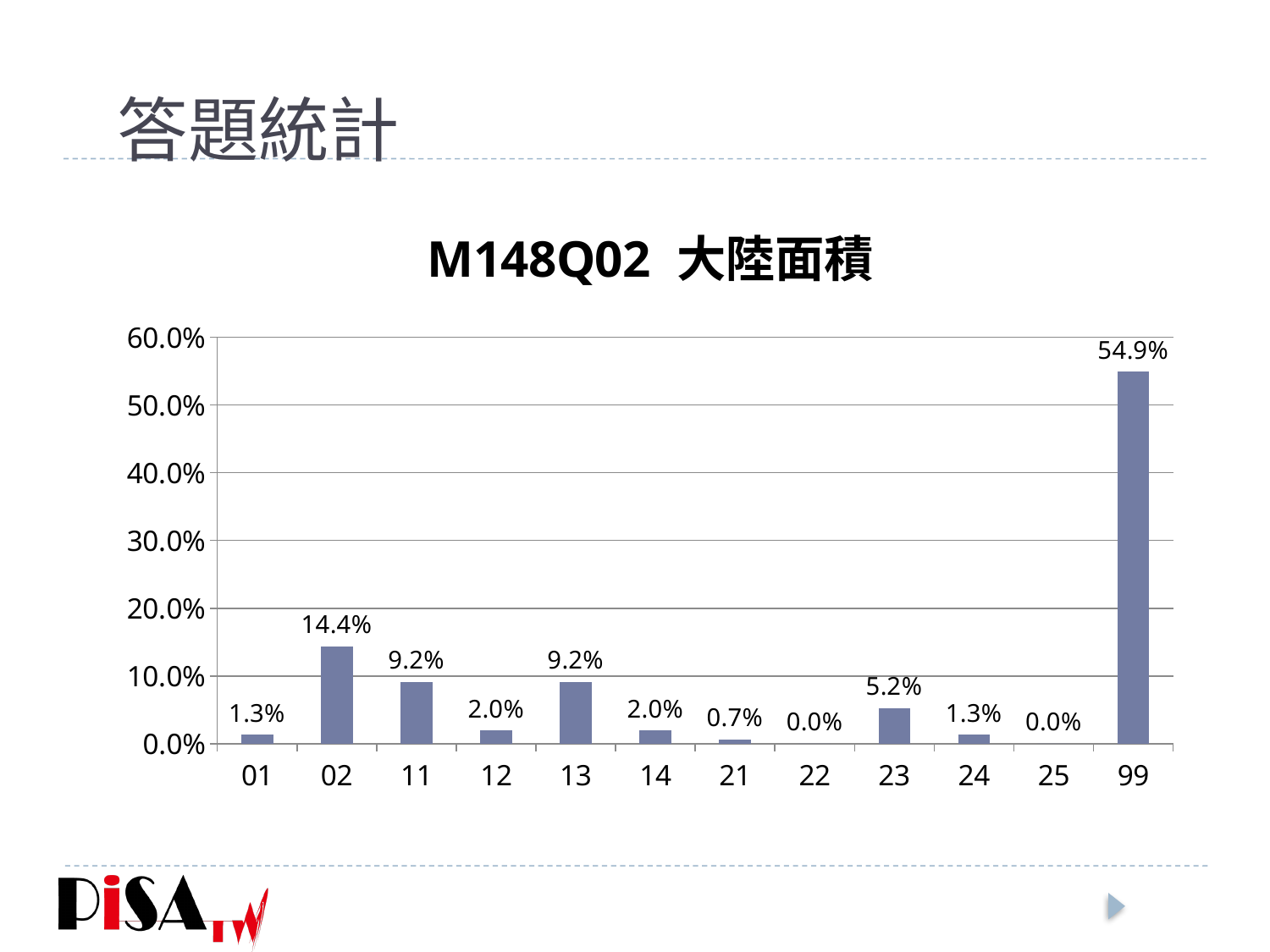
What kind of chart is this? bar chart Is the value for 99 greater or less than 50.0%? greater What is the title of the chart? M148Q02 大陸面積 Which is larger, the value for 23 or the value for 24? 23 What is the value for category 02? 14.4% What is the difference between the values for 99 and 02? 40.5% What is the difference between the values for 02 and 11? 5.2% Which category has the highest value? 99 What is the value for category 23? 5.2% How many categories are shown on the x axis? 12 What is the value for category 99? 54.9% What is the value for category 21? 0.7%